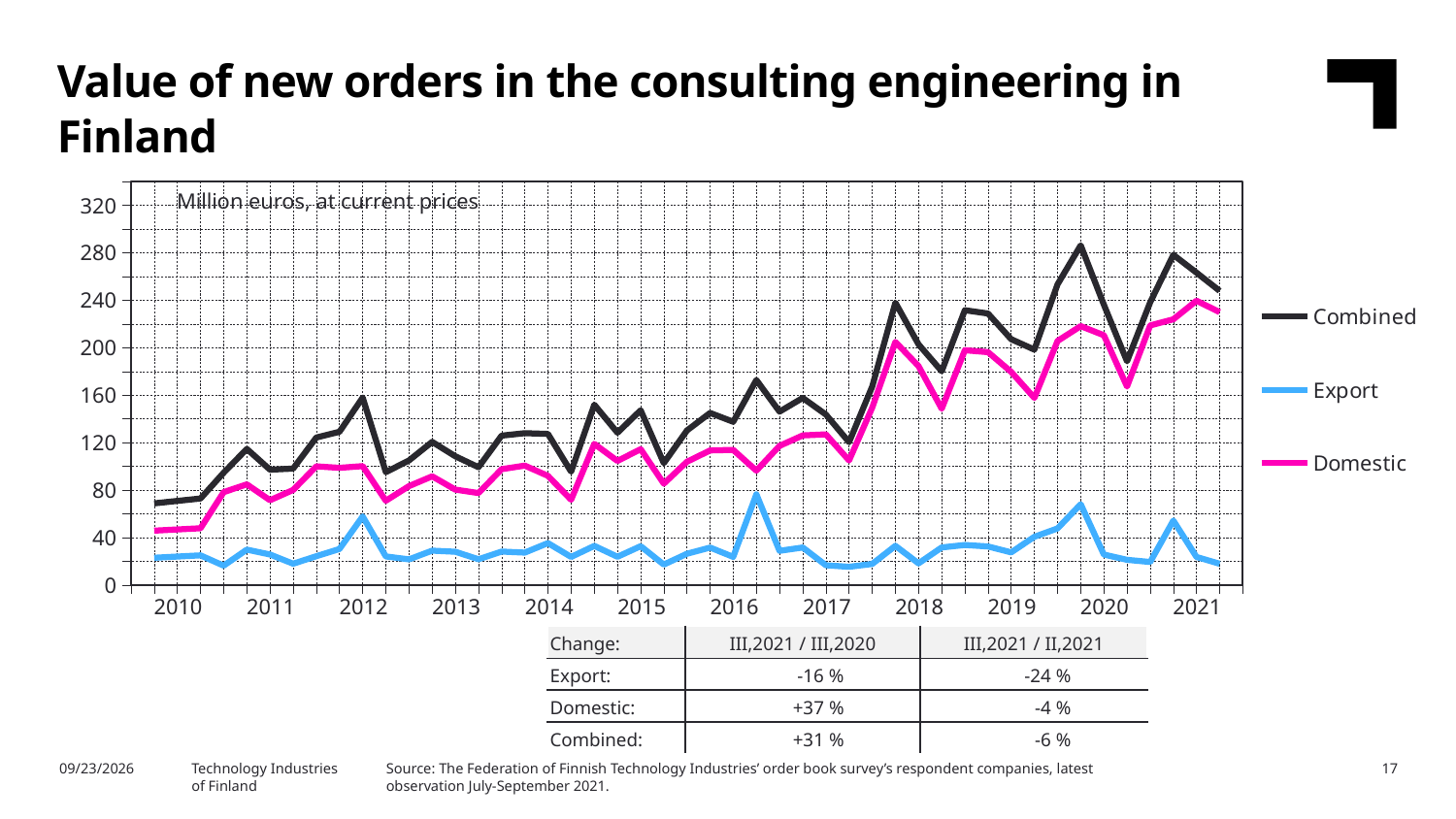
In 2018, which series has larger values, Domestic or Export? Domestic Is the peak value of the Combined series in 2019 greater or less than 240? greater Which series has the highest values throughout the chart? Combined Is the last plotted value of the Export series in 2021 greater or less than 40? less Which series has the lowest values throughout the chart? Export How many years are labelled on the x axis? 12 Which series is shown in pink in the chart? Domestic What unit is stated for the values in the chart? Million euros, at current prices Is the value of the Domestic series at the start of 2010 greater or less than 80? less What type of chart is shown on the slide? line chart Does the Combined series rise or fall overall from 2010 to 2021? rise How many series does the legend list? 3